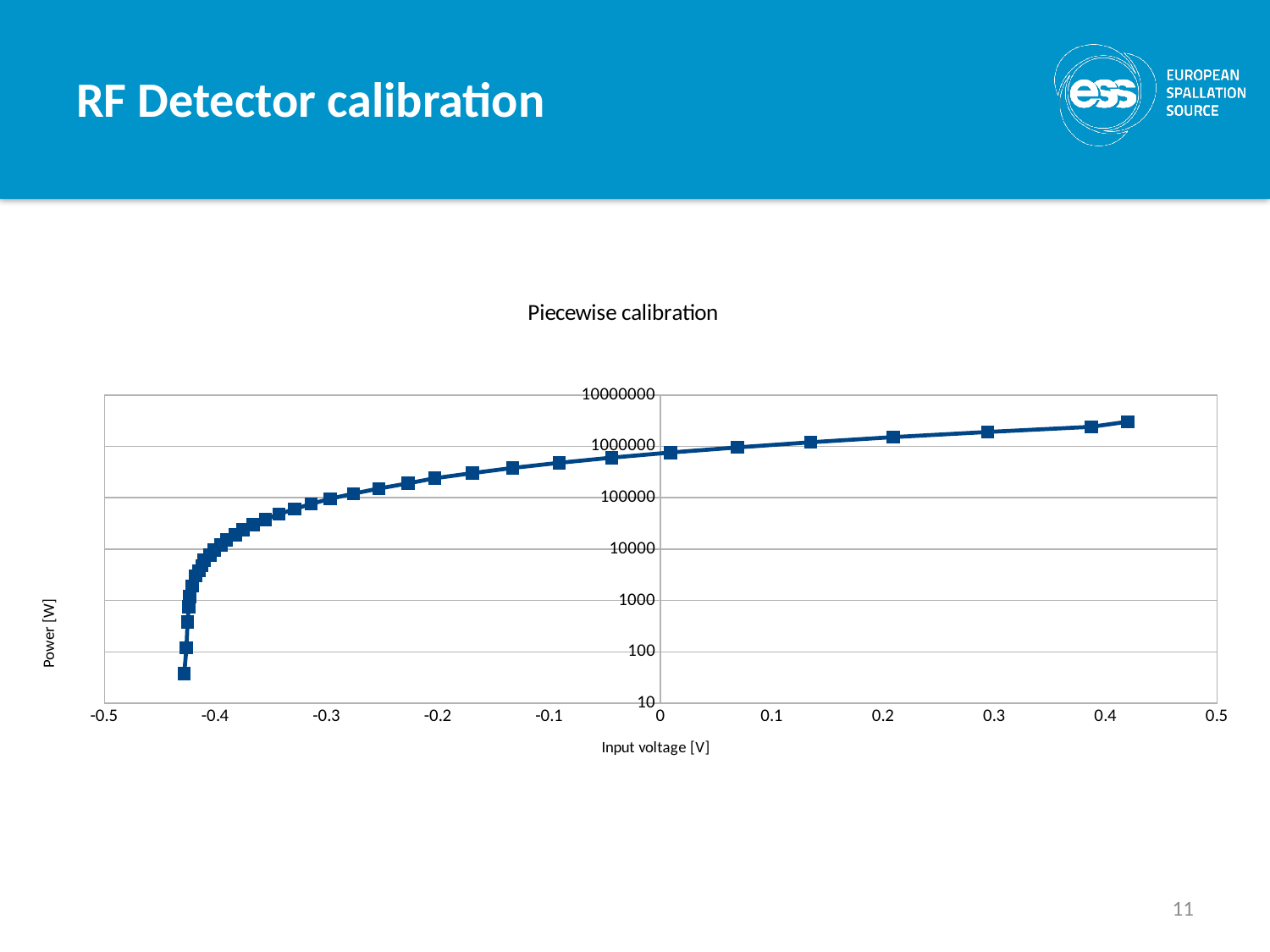
What is the label of the x axis? Input voltage [V] Is the power at an input voltage of -0.4 V greater or less than 100000? less What is the title of the chart? Piecewise calibration Is the power at an input voltage of 0.4 V greater or less than 1000000? greater Is the power at an input voltage of -0.2 V greater or less than 1000000? less What is the highest value shown on the y axis? 10000000 Does the power rise or fall as the input voltage increases along the x axis? rise What kind of chart is shown on the slide? line chart Which has the higher power: the point at input voltage 0.2 V or the point at -0.2 V? 0.2 V